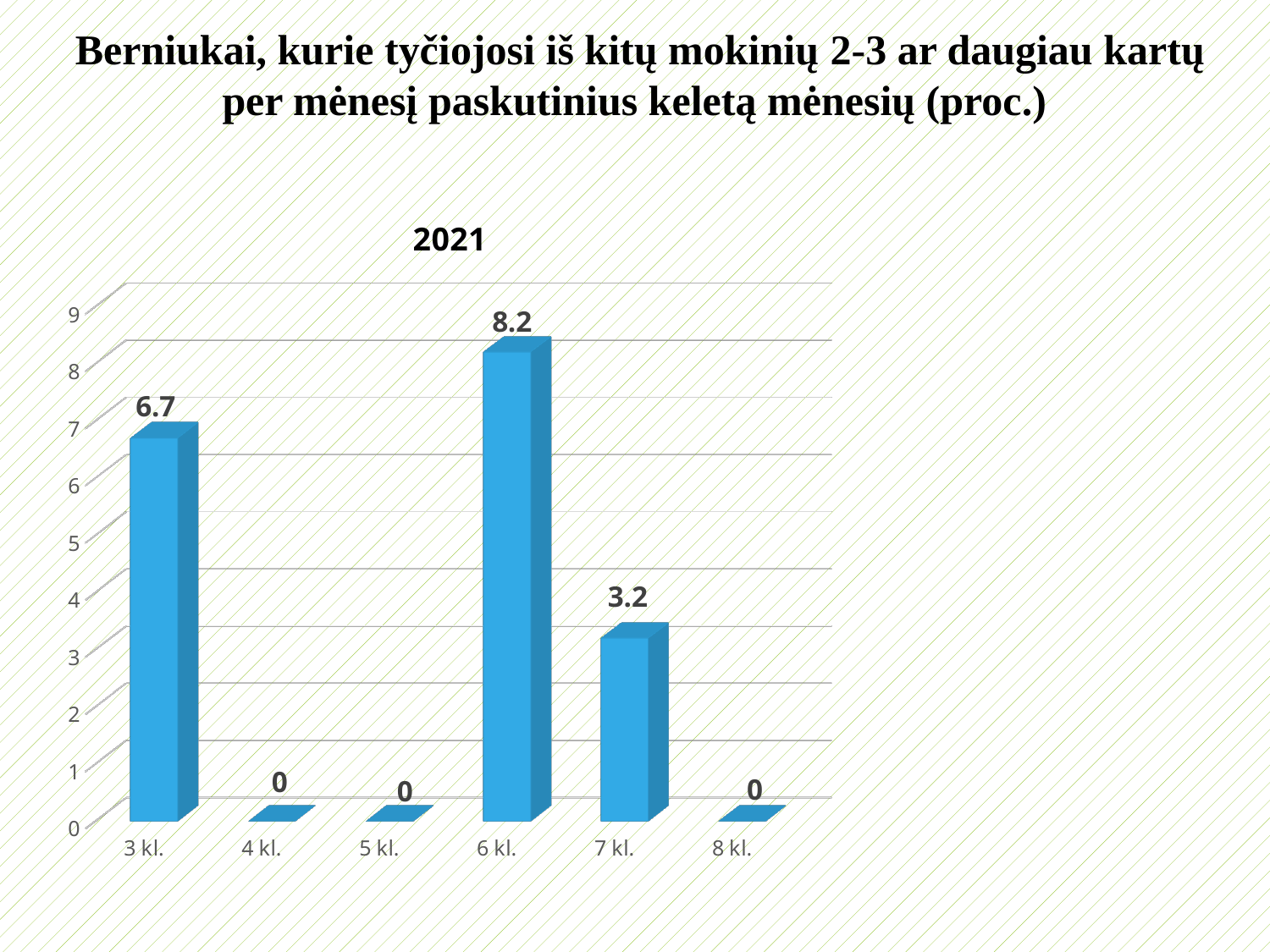
What is the value for 6 kl.? 8.2 What is the difference between the values for 3 kl. and 7 kl.? 3.5 What kind of chart is this? bar chart How many classes are shown on the x axis? 6 What is the chart's title shown above the plot area? 2021 What is the difference between the values for 6 kl. and 3 kl.? 1.5 What is the value for 7 kl.? 3.2 Which is larger, the value for 3 kl. or the value for 7 kl.? 3 kl. Which class has the highest value? 6 kl. Is the value for 6 kl. greater or less than 8? greater What is the value for 3 kl.? 6.7 What is the value for 4 kl.? 0